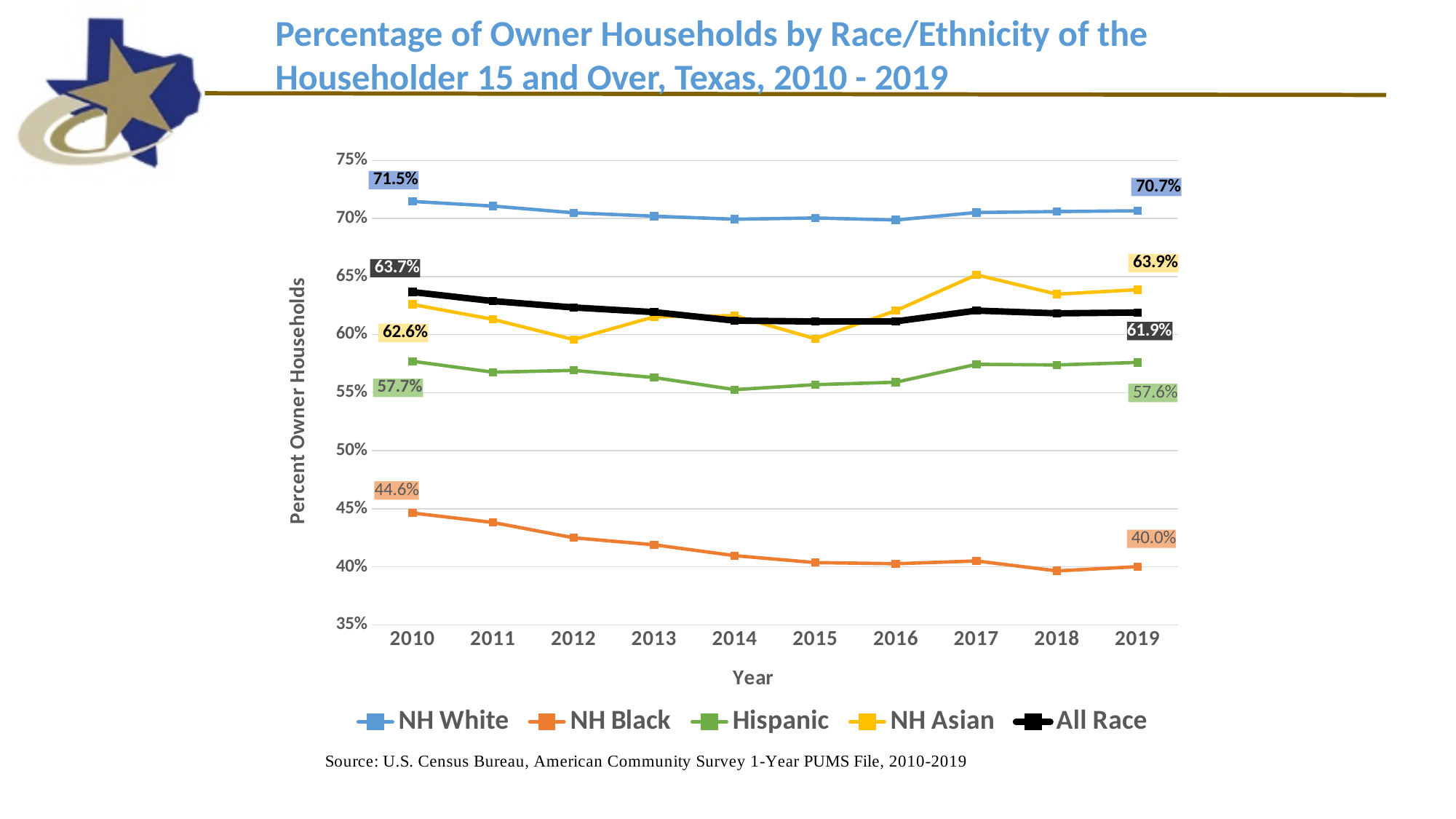
What was the percentage of owner households for NH Asian in 2019? 63.9% Which group had the lowest percentage of owner households in 2019? NH Black How many years are shown on the x axis? 10 What was the percentage of owner households for NH Black in 2019? 40.0% Which group had the highest percentage of owner households in 2010? NH White What was the percentage of owner households for NH White in 2010? 71.5% Which was larger in 2019, the NH Asian percentage or the All Race percentage? NH Asian By how many percentage points did the NH Black percentage of owner households change from 2010 to 2019? 4.6 percentage points lower What type of chart is shown on the slide? line chart Is the value for Hispanic in 2014 greater or less than 60%? less How many series does the legend list? 5 What was the All Race percentage of owner households in 2010? 63.7%